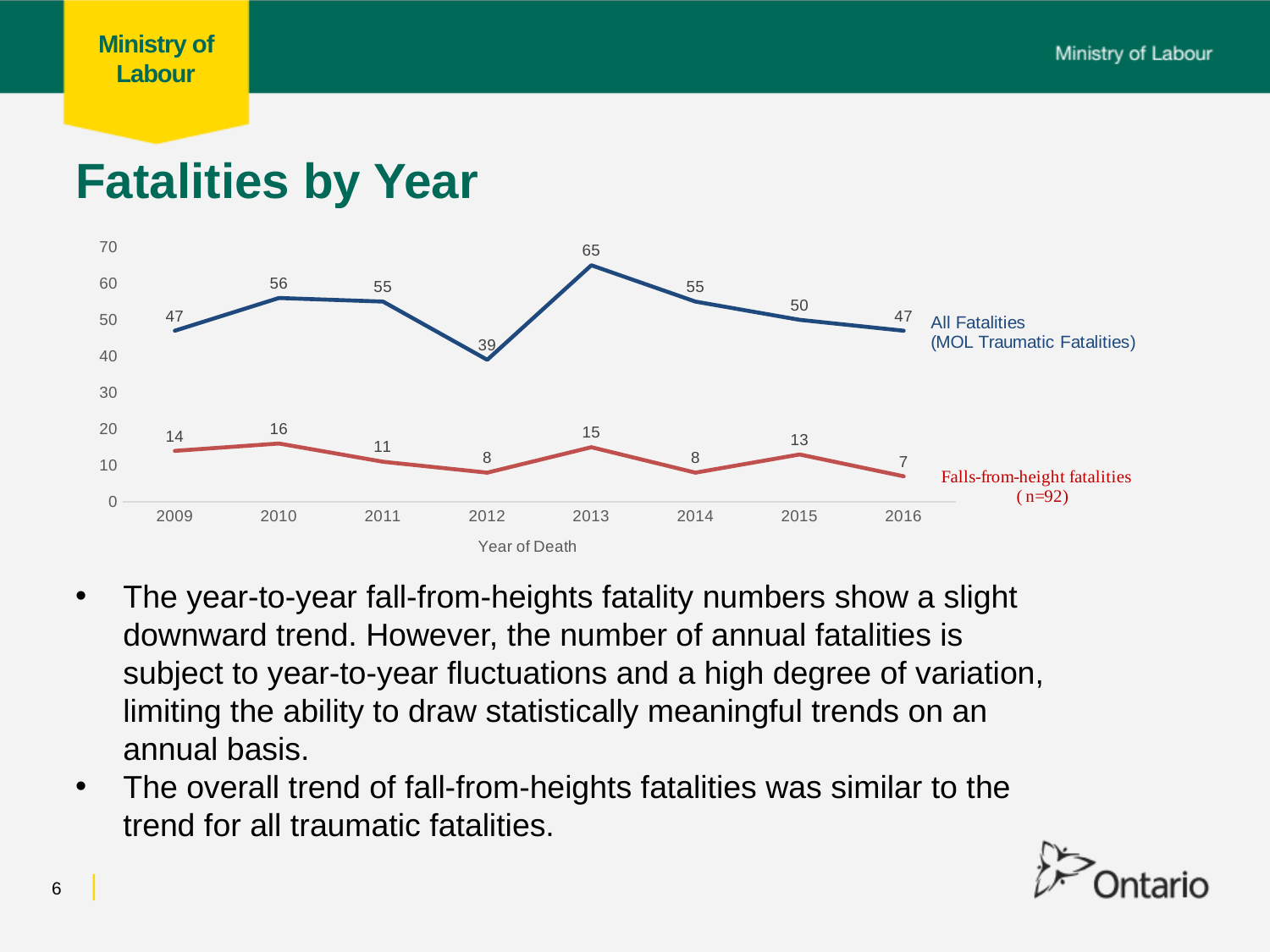
How many data series does the chart show? 2 Did All Fatalities rise or fall from 2013 to 2016? fall What was the number of All Fatalities in 2013? 65 In which year were falls-from-height fatalities highest? 2010 What was the number of falls-from-height fatalities in 2016? 7 How many years are plotted along the x axis? 8 What type of chart is shown on the slide? line chart In which year were All Fatalities lowest? 2012 What is the difference between All Fatalities and falls-from-height fatalities in 2009? 33 What is the x-axis title of the chart? Year of Death Which year had more falls-from-height fatalities, 2011 or 2015? 2015 What is the total sample size (n) given for the falls-from-height fatalities series? 92